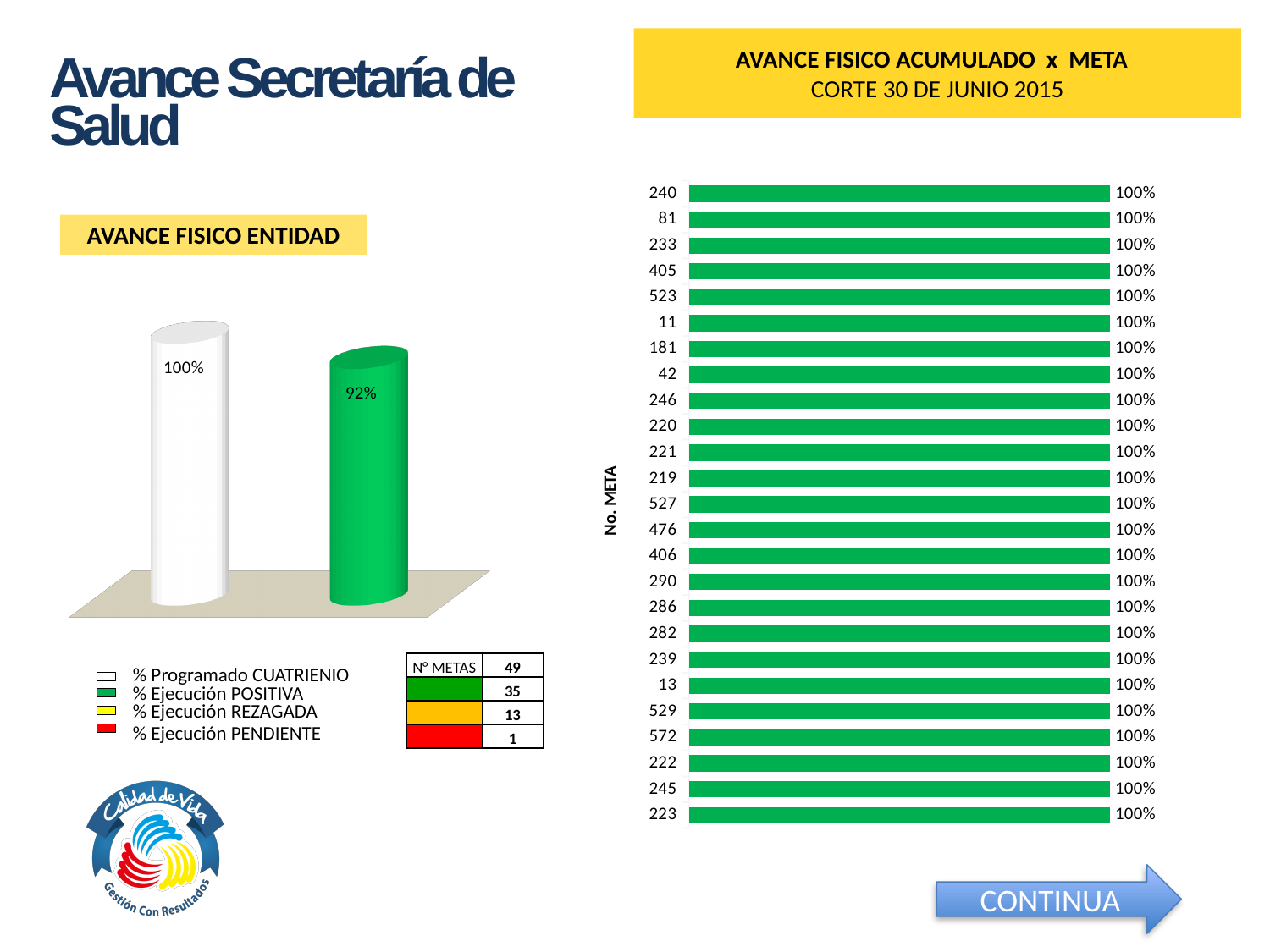
In the AVANCE FISICO ENTIDAD chart, how many entries does the legend list? 4 In the AVANCE FISICO ENTIDAD chart, what is the value of the green bar (% Ejecución POSITIVA)? 92% What kind of chart is the AVANCE FISICO ENTIDAD chart? bar chart In the AVANCE FISICO ENTIDAD chart, what is the value of the white bar (% Programado CUATRIENIO)? 100% In the AVANCE FISICO ACUMULADO x META chart, how many metas (bars) are shown? 25 In the AVANCE FISICO ENTIDAD chart, which bar is taller, the white one or the green one? the white one In the AVANCE FISICO ENTIDAD chart, what is the difference between the white bar and the green bar? 8% In the AVANCE FISICO ACUMULADO x META chart, what is the value for meta 240? 100% In the AVANCE FISICO ACUMULADO x META chart, what is the value for meta 572? 100% What kind of chart is the AVANCE FISICO ACUMULADO x META chart? bar chart In the AVANCE FISICO ENTIDAD chart, how many bars are plotted? 2 What is the label of the vertical axis in the AVANCE FISICO ACUMULADO x META chart? No. META